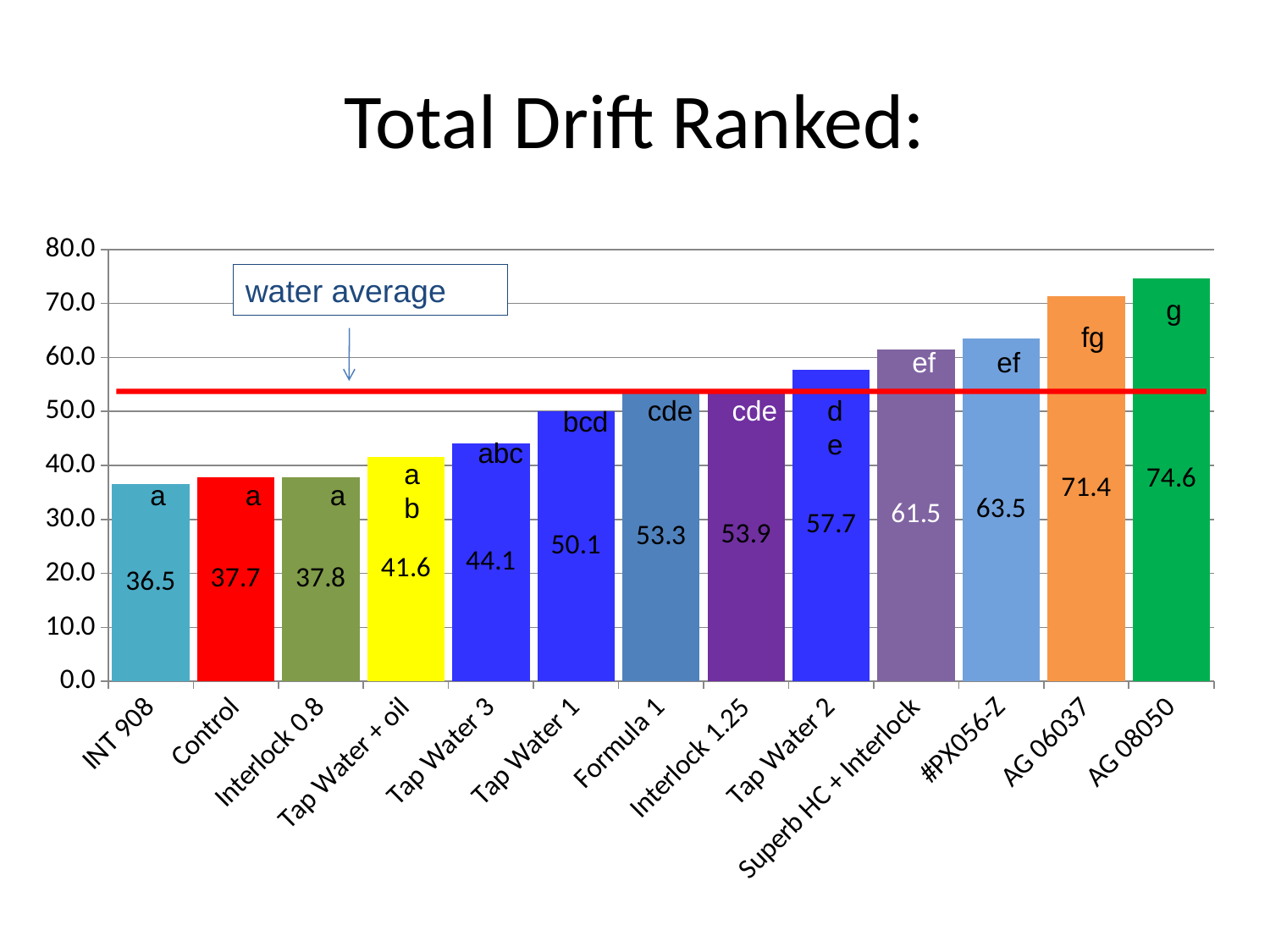
What is the value for Tap Water 1? 50.1 What is the difference between the values for AG 08050 and INT 908? 38.1 What is the value for Control? 37.7 What kind of chart is this? bar chart What is the difference between the values for AG 06037 and #PX056-Z? 7.9 How many categories are shown on the x axis? 13 What is the value for Superb HC + Interlock? 61.5 Which category has the lowest value? INT 908 Do the bar values rise or fall from left to right along the x axis? rise Which is larger, the value for Formula 1 or the value for Tap Water 3? Formula 1 What does the red horizontal line represent? water average Which category has the highest value? AG 08050